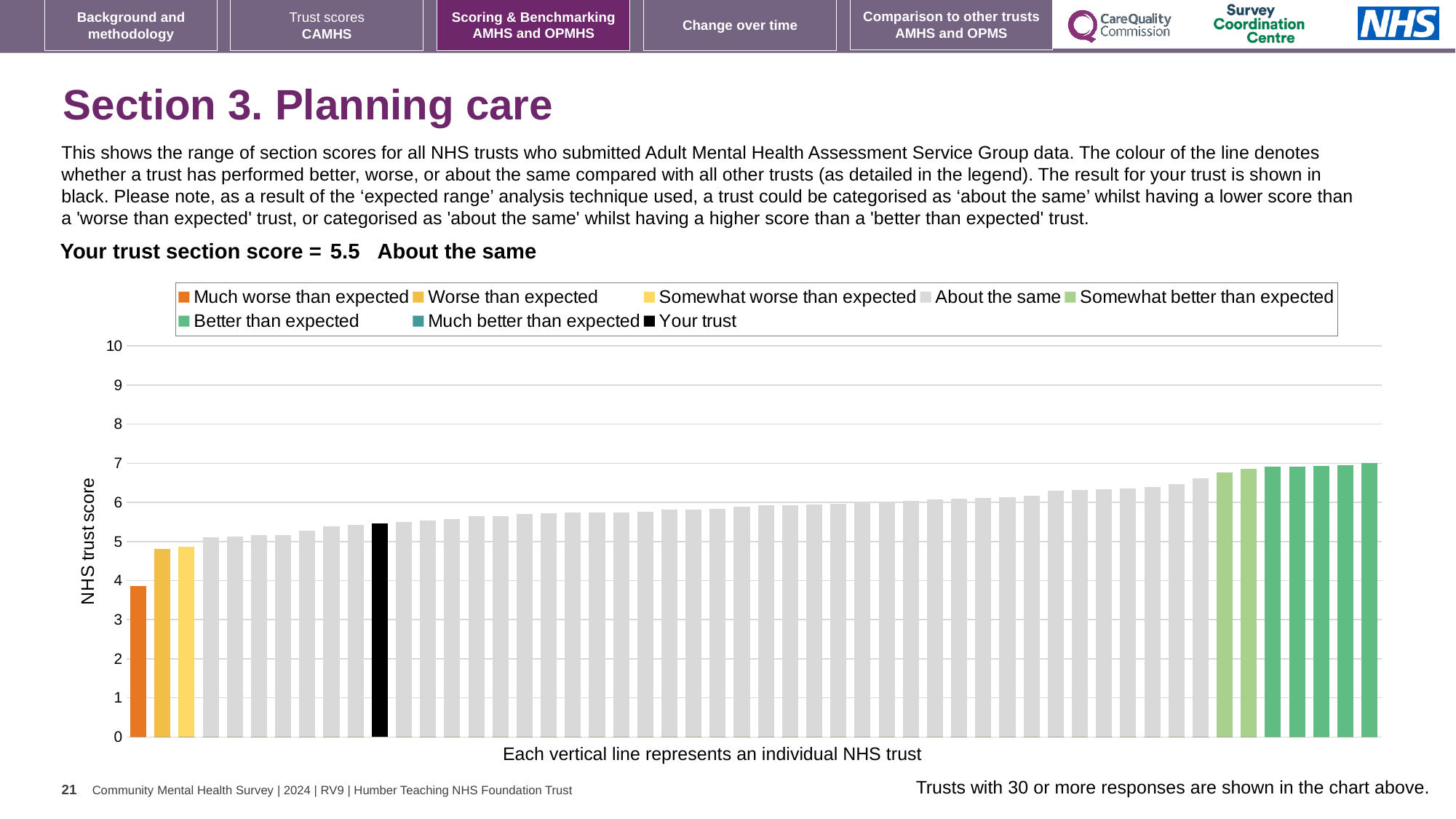
Is the value for your trust (the black bar) greater or less than 5? greater Do the bar values rise or fall from left to right along the x axis? rise Which legend category does the highest-scoring trust on the chart belong to? Better than expected What is the label on the vertical axis of the chart? NHS trust score How many bars are coloured as 'Worse than expected' (yellow) on the chart? 1 Which performance category is your trust placed in for this section? About the same Is the value of the lowest bar (the orange bar) greater or less than 5? less What is the section score for your trust shown on the slide? 5.5 Which legend category does the lowest-scoring trust on the chart belong to? Much worse than expected Is the value of the highest bar on the chart greater or less than 6? greater What kind of chart is shown on the slide? Bar chart How many entries does the chart legend list? 8